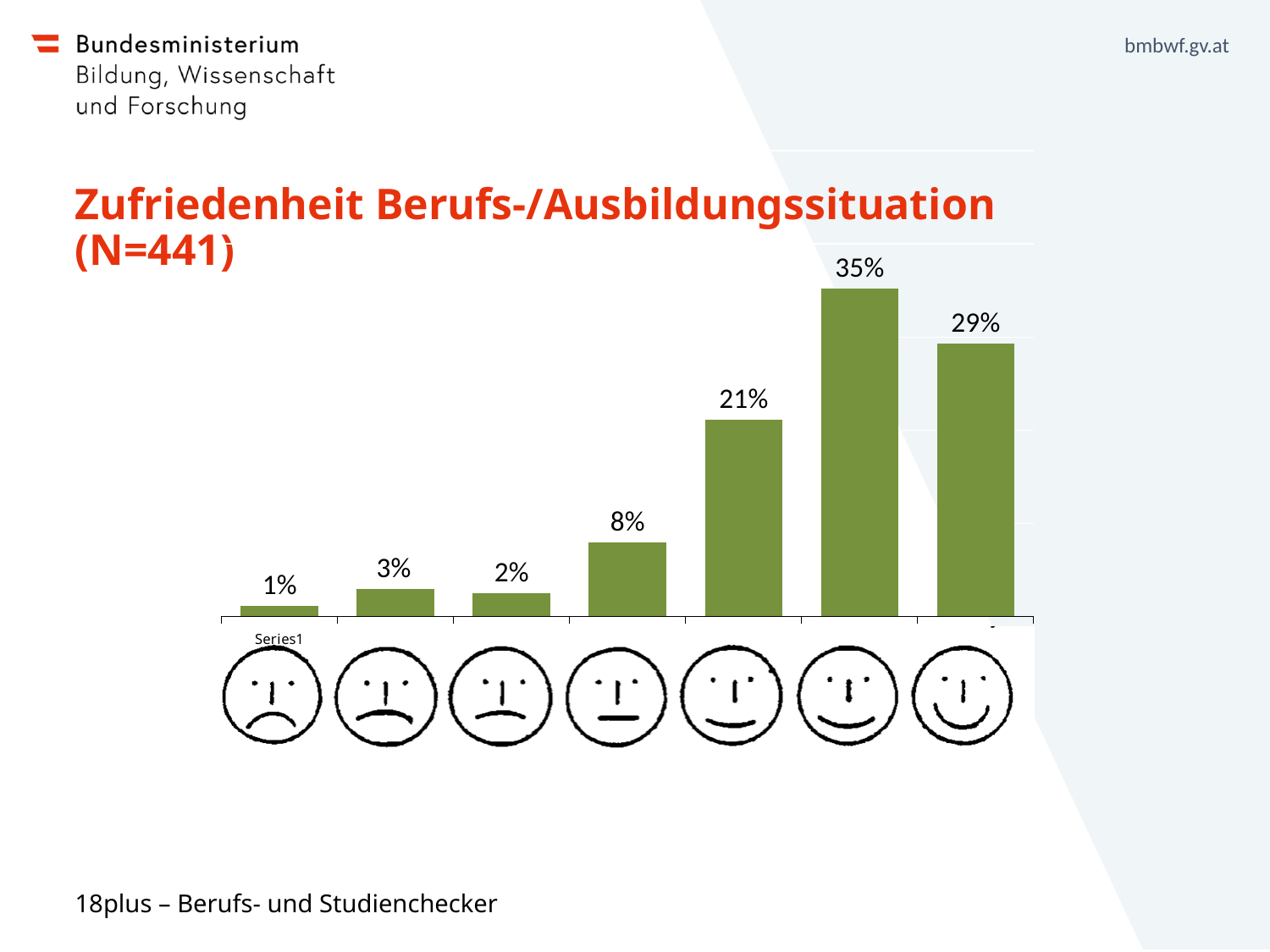
What is the title of the chart on the slide? Zufriedenheit Berufs-/Ausbildungssituation (N=441) What is the difference between the highest bar (35%) and the rightmost bar (29%)? 6% Which bar has the highest value in the chart? The sixth bar from the left (35%) What is the value of the fourth bar from the left (the neutral face)? 8% What is the value of the leftmost bar (the saddest face) in the chart? 1% What type of chart is shown on the slide? Bar chart Which bar has the lowest value in the chart? The leftmost bar (1%) What is the value of the rightmost bar (the happiest face) in the chart? 29% What colour are the bars in the chart? Green What is the value of the fifth bar from the left? 21% How many bars are shown in the chart? 7 Which is larger: the second bar from the left or the third bar from the left? The second bar (3%)